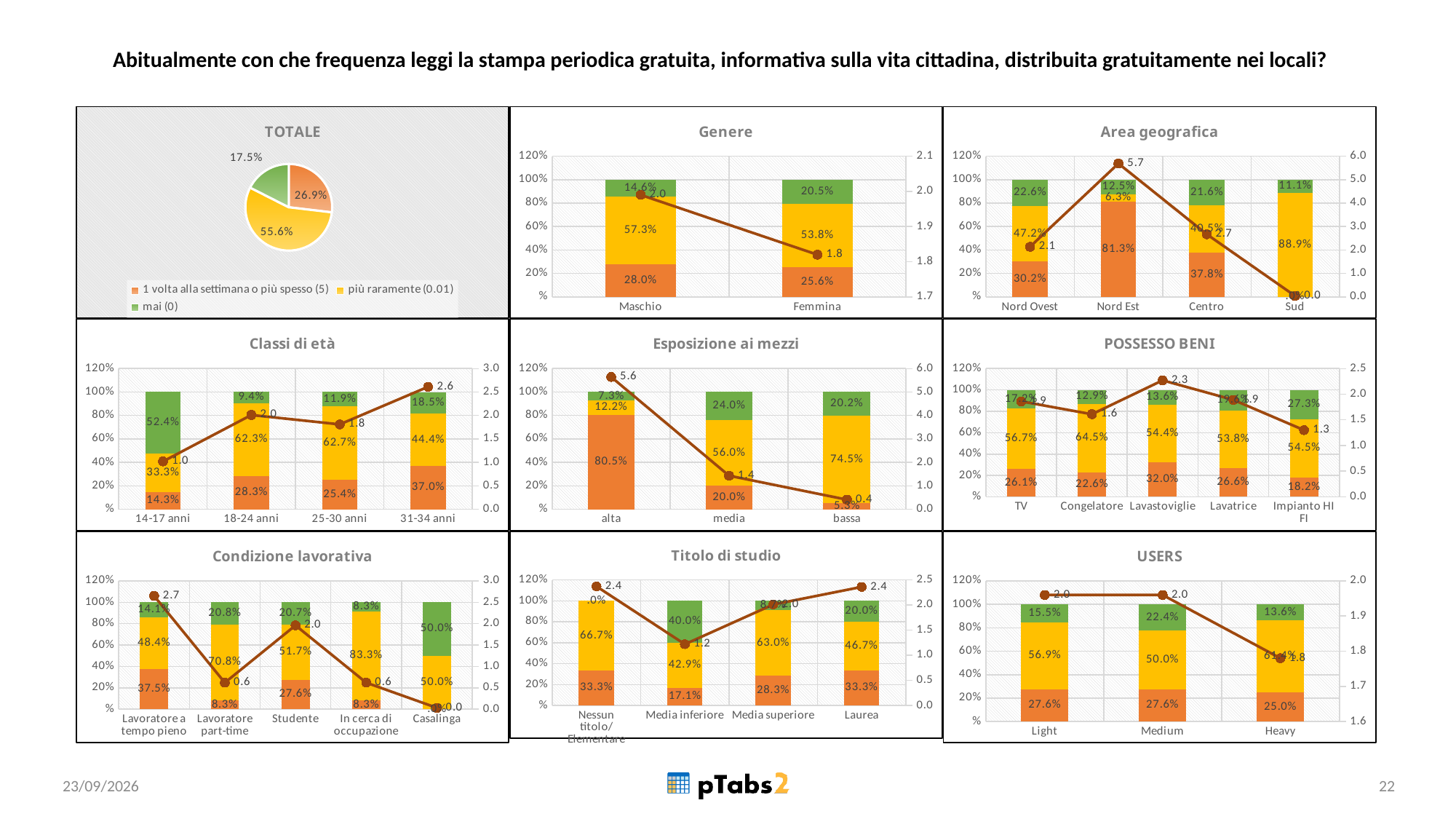
In the Area geografica chart, what is the value of the yellow segment for Sud? 88.9% In the Esposizione ai mezzi chart, what is the difference between the orange segment for alta and the orange segment for media? 60.5% In the TOTALE pie chart, how many slices are there? 3 In the Classi di età chart, what is the line value for 31-34 anni? 2.6 In the TOTALE pie chart, what share is shown for the largest slice? 55.6% In the Genere chart, what is the value of the orange segment for Femmina? 25.6% In the Condizione lavorativa chart, is the yellow segment for Lavoratore part-time larger or smaller than the yellow segment for Studente? larger In the Titolo di studio chart, what is the value of the green segment for Media inferiore? 40.0% In the USERS chart, what is the line value for Heavy? 1.8 In the Area geografica chart, which category has the highest line value? Nord Est In the Classi di età chart, which category has the lowest line value? 14-17 anni In the POSSESSO BENI chart, how many categories are shown on the x axis? 5